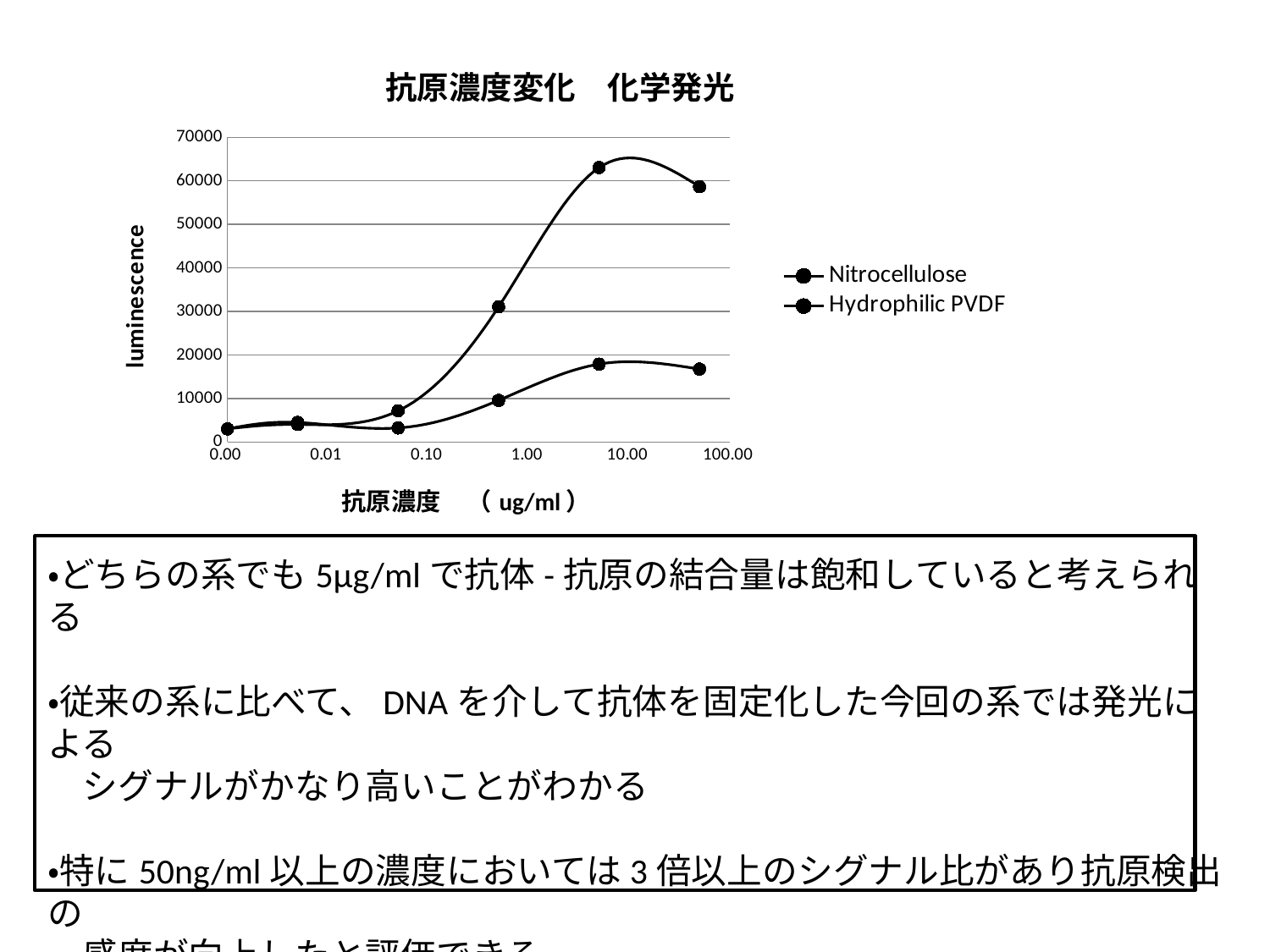
How many data points are plotted on each line? 6 Is the highest plotted value on the chart greater or less than 60000? greater What is the title of the chart? 抗原濃度変化 化学発光 What kind of chart is shown on the slide? line chart Is the highest value of the lower line greater or less than 20000? less Between 0.01 and 10.00 on the x axis, do the values of the upper line rise or fall? rise What are the two series named in the legend? Nitrocellulose and Hydrophilic PVDF How many series does the legend list? 2